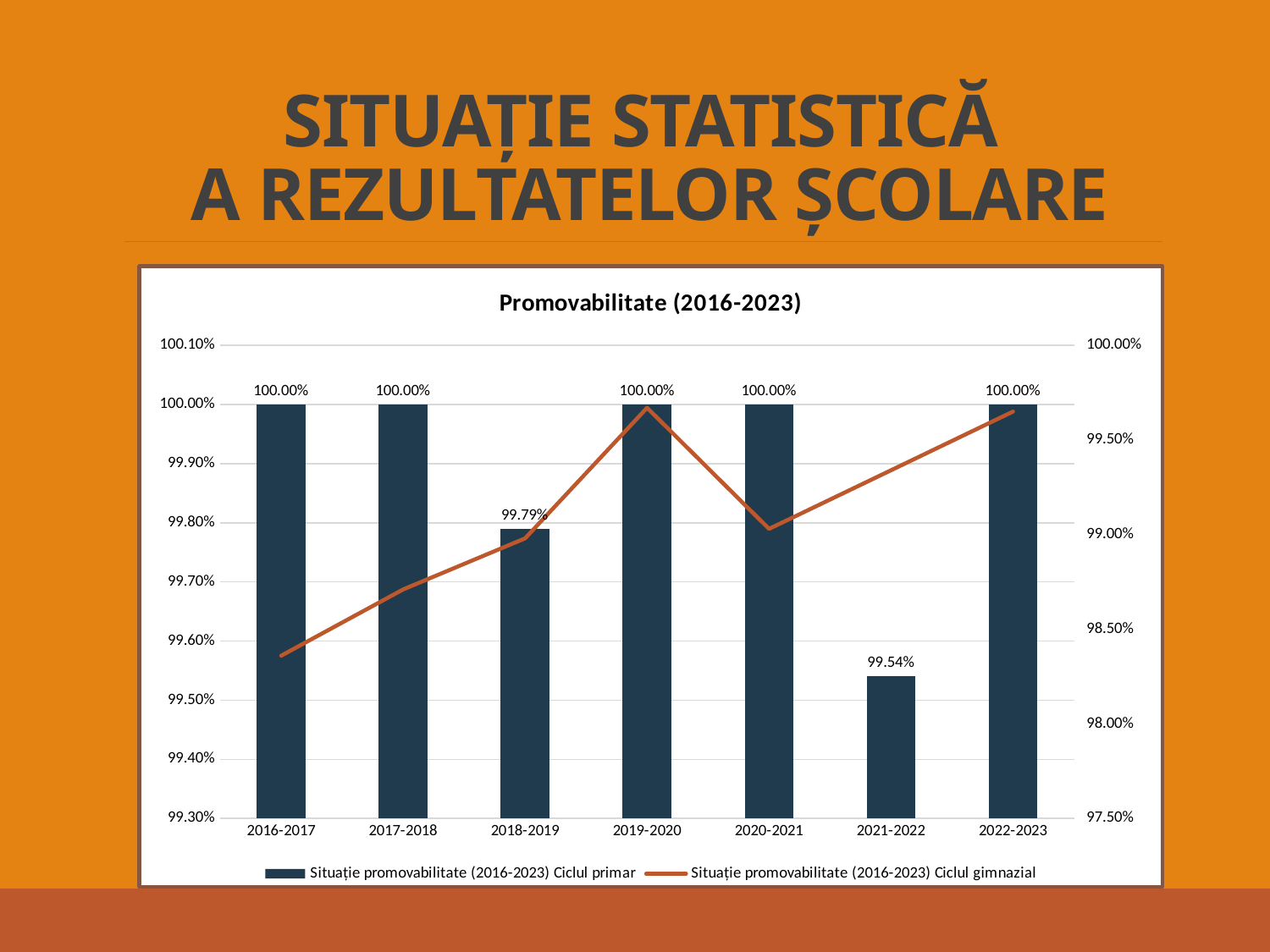
What kind of chart is shown? Combined bar and line chart Is the Ciclul gimnazial value for 2016-2017 greater or less than 98.50%? less Which has the larger Ciclul primar value, 2018-2019 or 2021-2022? 2018-2019 In which school year does the Ciclul gimnazial line reach its highest point? 2019-2020 How many school years are shown on the x axis? 7 What is the title of the chart? Promovabilitate (2016-2023) Which school year has the lowest Ciclul primar value? 2021-2022 What is the difference between the Ciclul primar values for 2018-2019 and 2021-2022? 0.25% Is the Ciclul gimnazial value for 2019-2020 greater or less than 99.50%? greater What is the value of the Ciclul primar bar for 2021-2022? 99.54% How many series does the legend list? 2 What is the value of the Ciclul primar bar for 2018-2019? 99.79%